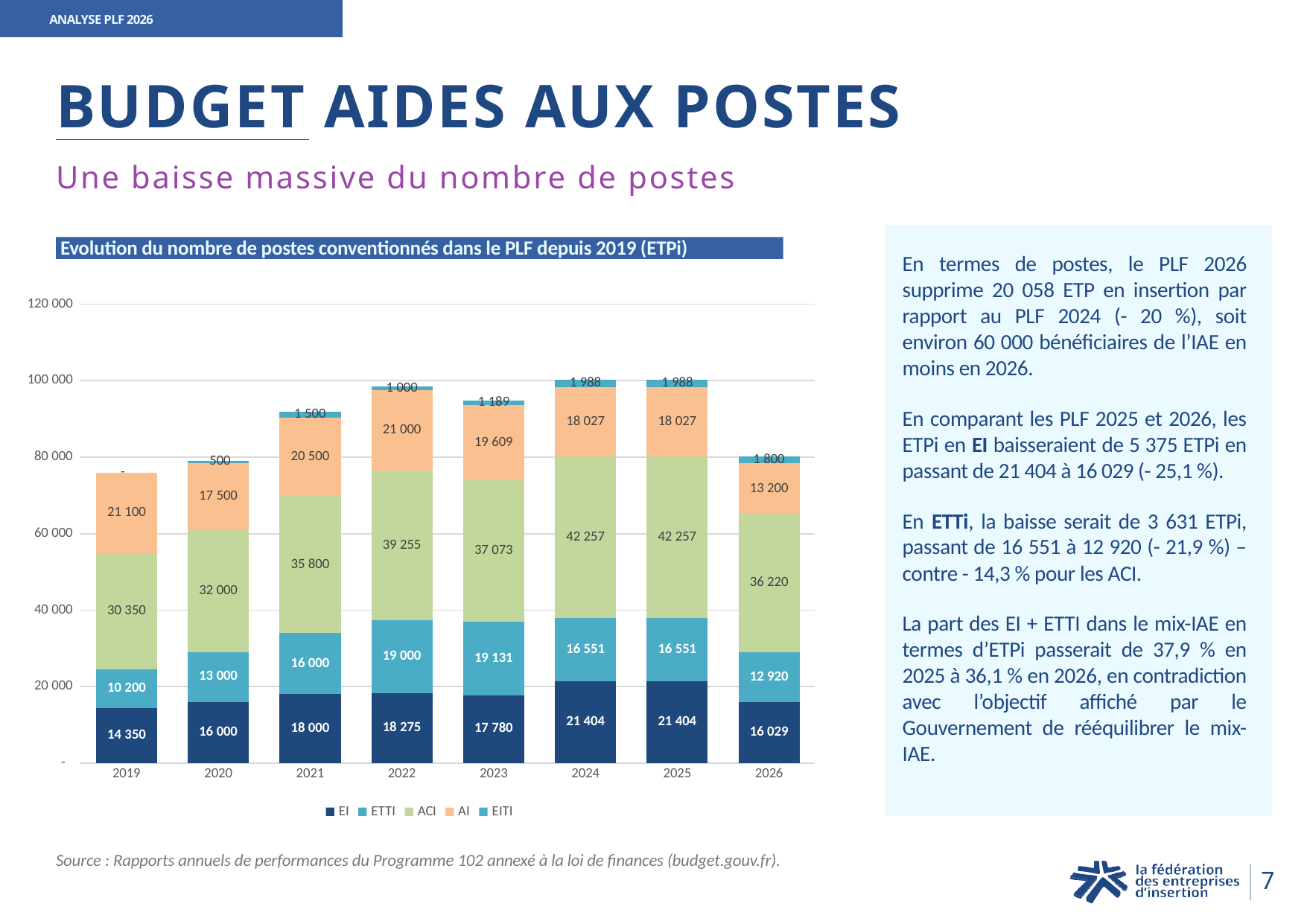
What is the value for EI in 2026? 16 029 In which year is the AI value lowest? 2026 What is the value for EITI in 2024? 1 988 What is the total of the stacked bar for 2026? 80 169 How many series does the chart legend list? 5 In which year is the ETTI value lowest? 2019 What type of chart is shown on the slide? Stacked bar chart What is the value for ACI in 2022? 39 255 How many years are shown on the x axis of the chart? 8 What is the difference between the EI value in 2025 and in 2026? 5 375 Is the total of the stacked bar for 2021 greater or less than 80 000? greater Which is larger, the ACI value in 2021 or in 2023? 2023